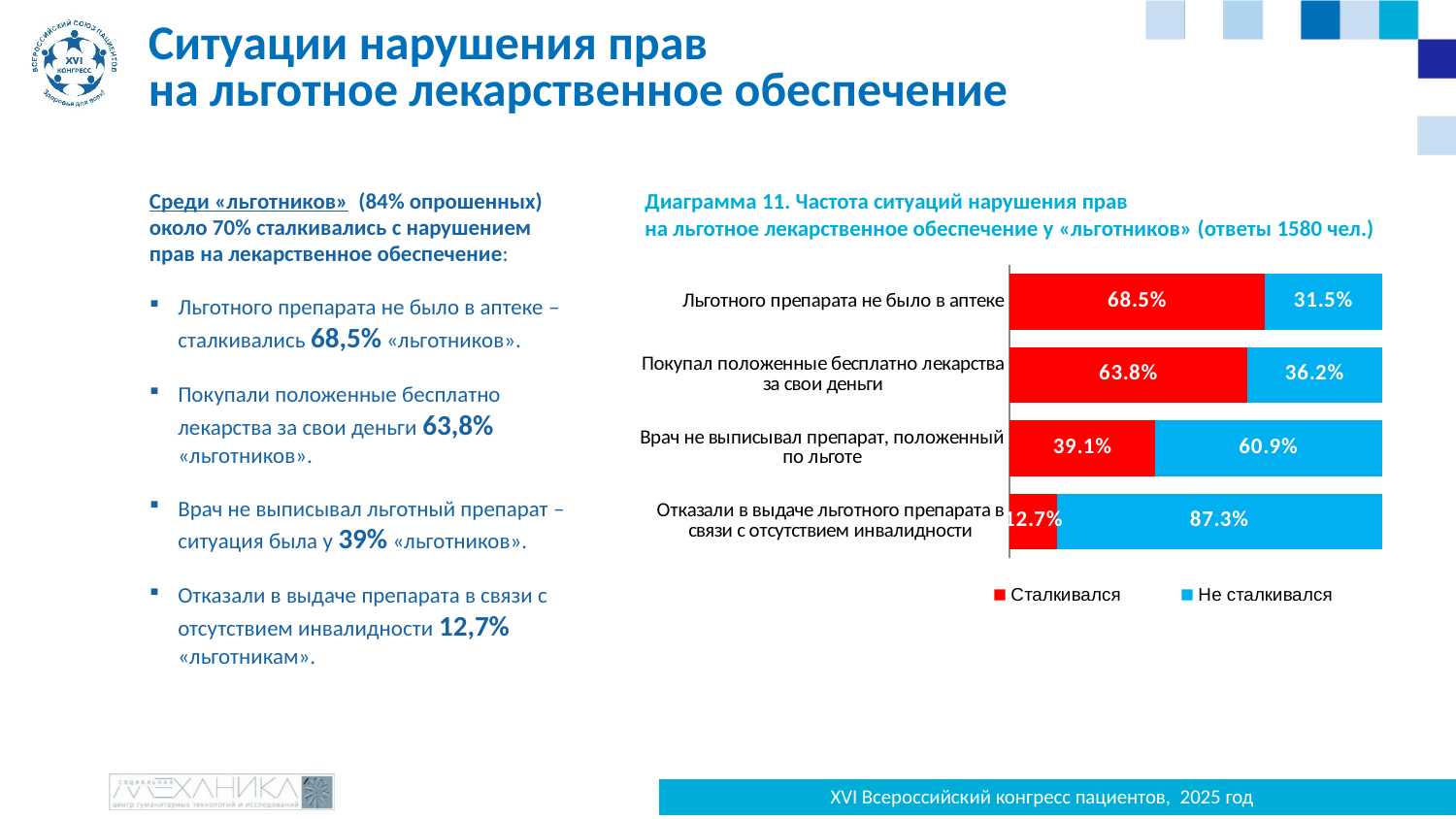
Which category has the highest «Сталкивался» value? Льготного препарата не было в аптеке What is the value of «Сталкивался» for «Льготного препарата не было в аптеке»? 68.5% What is the value of «Не сталкивался» for «Отказали в выдаче льготного препарата в связи с отсутствием инвалидности»? 87.3% What type of chart is shown on the slide? Stacked bar chart Which category has the lowest «Сталкивался» value? Отказали в выдаче льготного препарата в связи с отсутствием инвалидности How many series does the legend list? 2 What is the difference between the «Сталкивался» values for «Льготного препарата не было в аптеке» and «Покупал положенные бесплатно лекарства за свои деньги»? 4.7% What is the value of «Не сталкивался» for «Покупал положенные бесплатно лекарства за свои деньги»? 36.2% Which series is shown in red in the chart? Сталкивался How many categories are plotted in the chart? 4 What is the value of «Сталкивался» for «Врач не выписывал препарат, положенный по льготе»? 39.1% Which is larger for «Врач не выписывал препарат, положенный по льготе»: «Сталкивался» or «Не сталкивался»? Не сталкивался